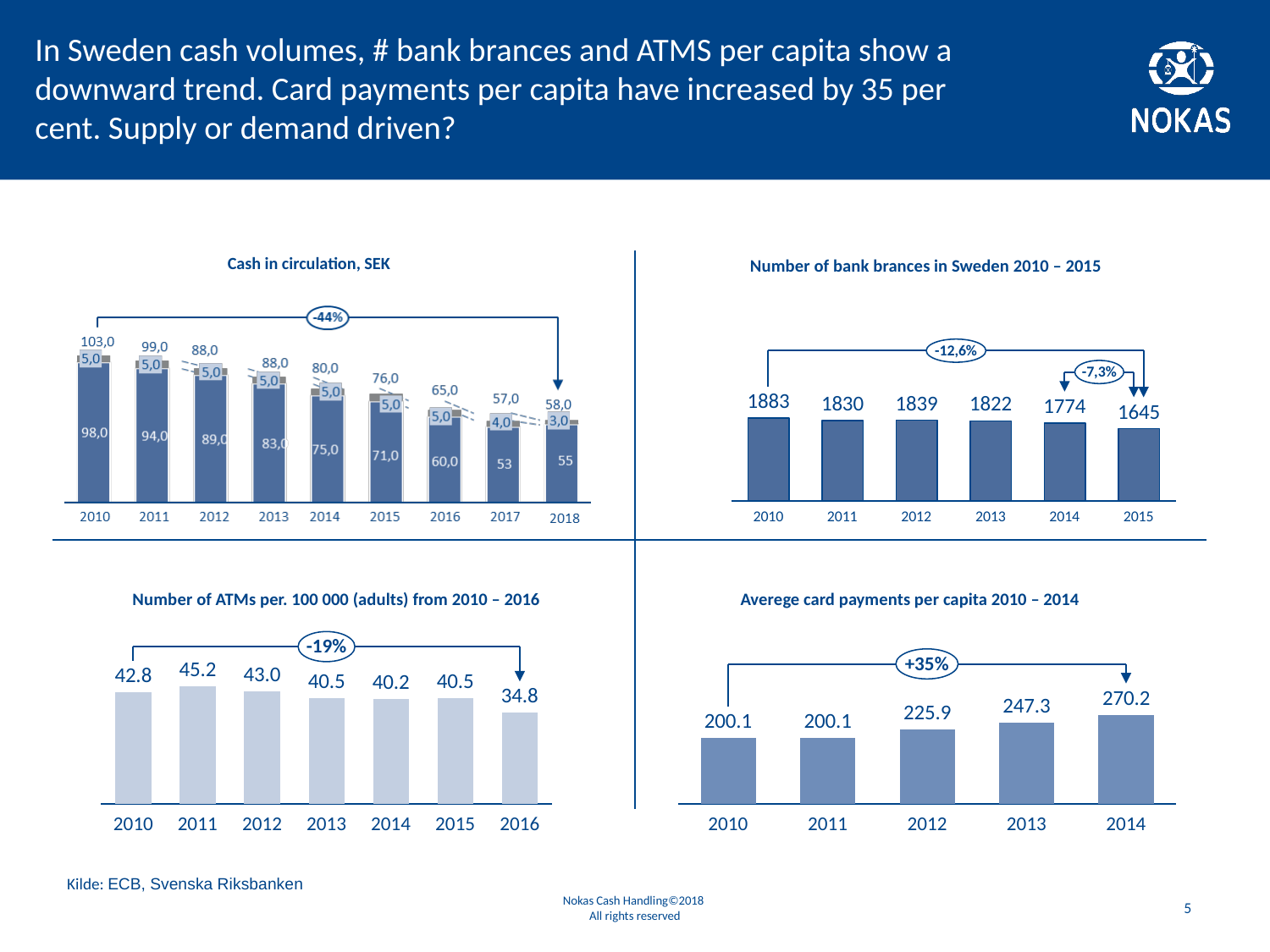
How many years are shown in the 'Number of ATMs per. 100 000 (adults) from 2010 – 2016' chart? 7 In the 'Averege card payments per capita 2010 – 2014' chart, what is the value for 2013? 247.3 What kind of chart is the 'Number of bank brances in Sweden 2010 – 2015' chart? bar chart In the 'Number of ATMs per. 100 000 (adults) from 2010 – 2016' chart, what is the value for 2016? 34.8 In the 'Averege card payments per capita 2010 – 2014' chart, what is the difference between the 2014 and 2012 values? 44.3 In the 'Cash in circulation, SEK' chart, what is the value of the larger (lower) segment for 2014? 75,0 In the 'Averege card payments per capita 2010 – 2014' chart, do the values rise or fall from 2010 to 2014? rise In the 'Cash in circulation, SEK' chart, what is the total of the stacked bar for 2016? 65,0 In the 'Number of ATMs per. 100 000 (adults) from 2010 – 2016' chart, which year has the highest value? 2011 In the 'Number of bank brances in Sweden 2010 – 2015' chart, what is the difference between the 2010 and 2015 values? 238 In the 'Number of bank brances in Sweden 2010 – 2015' chart, what is the value for 2010? 1883 In the 'Number of bank brances in Sweden 2010 – 2015' chart, which year has the lowest value? 2015